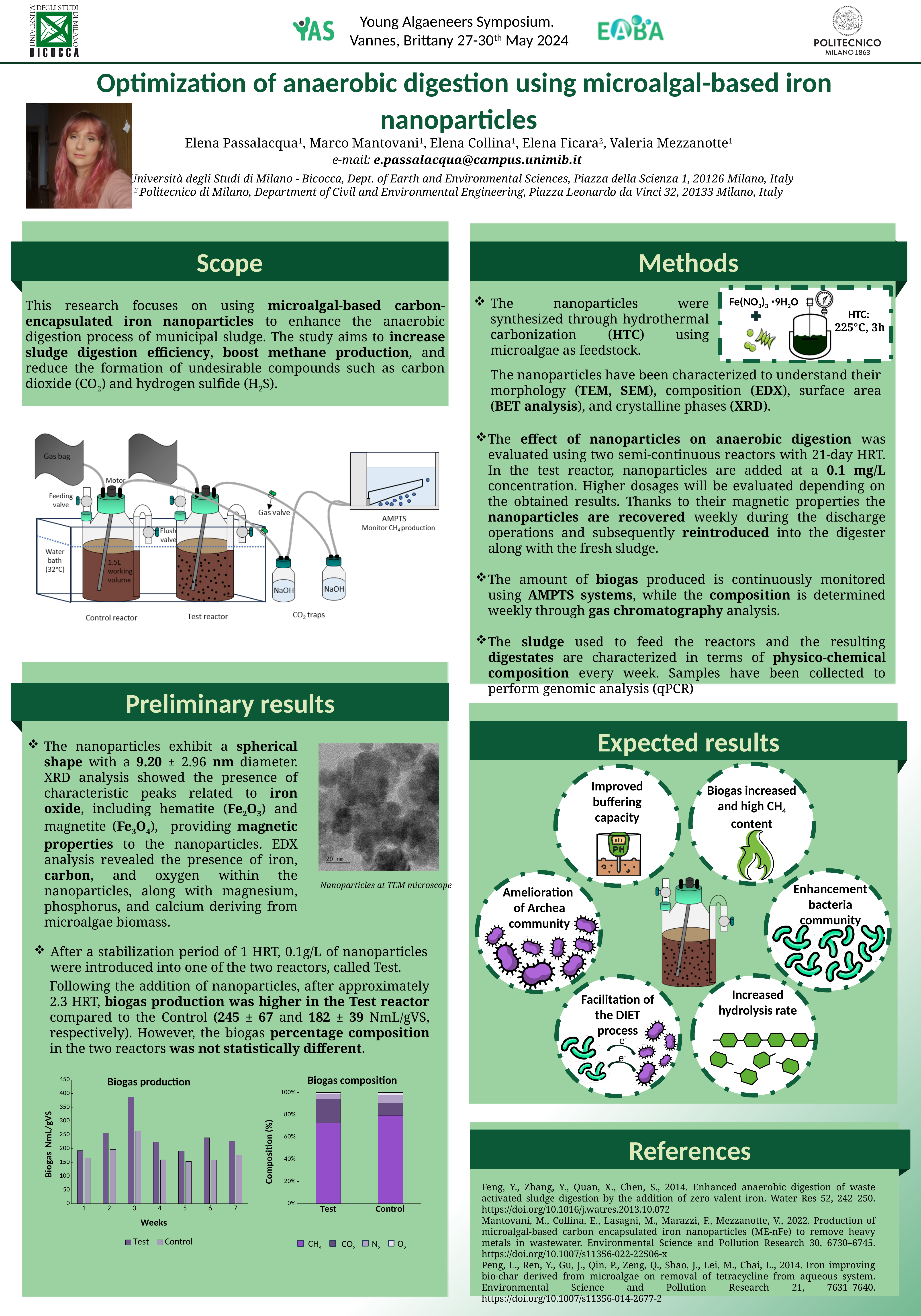
In the 'Biogas composition' chart, which reactor has the larger CH4 share, Test or Control? Control In the 'Biogas production' chart, which is larger in week 3, Test or Control? Test What kind of chart is the 'Biogas production' chart? bar chart How many weeks are shown on the x axis of the 'Biogas production' chart? 7 In the 'Biogas production' chart, is the Test value for week 2 greater or less than 200? greater How many series does the legend of the 'Biogas production' chart list? 2 In the 'Biogas production' chart, is the Control value for week 1 greater or less than 200? less In the 'Biogas composition' chart, is the CH4 share for Test greater or less than 80%? less How many series does the legend of the 'Biogas composition' chart list? 4 In the 'Biogas production' chart, which week has the highest Test value? Week 3 What kind of chart is the 'Biogas composition' chart? stacked bar chart